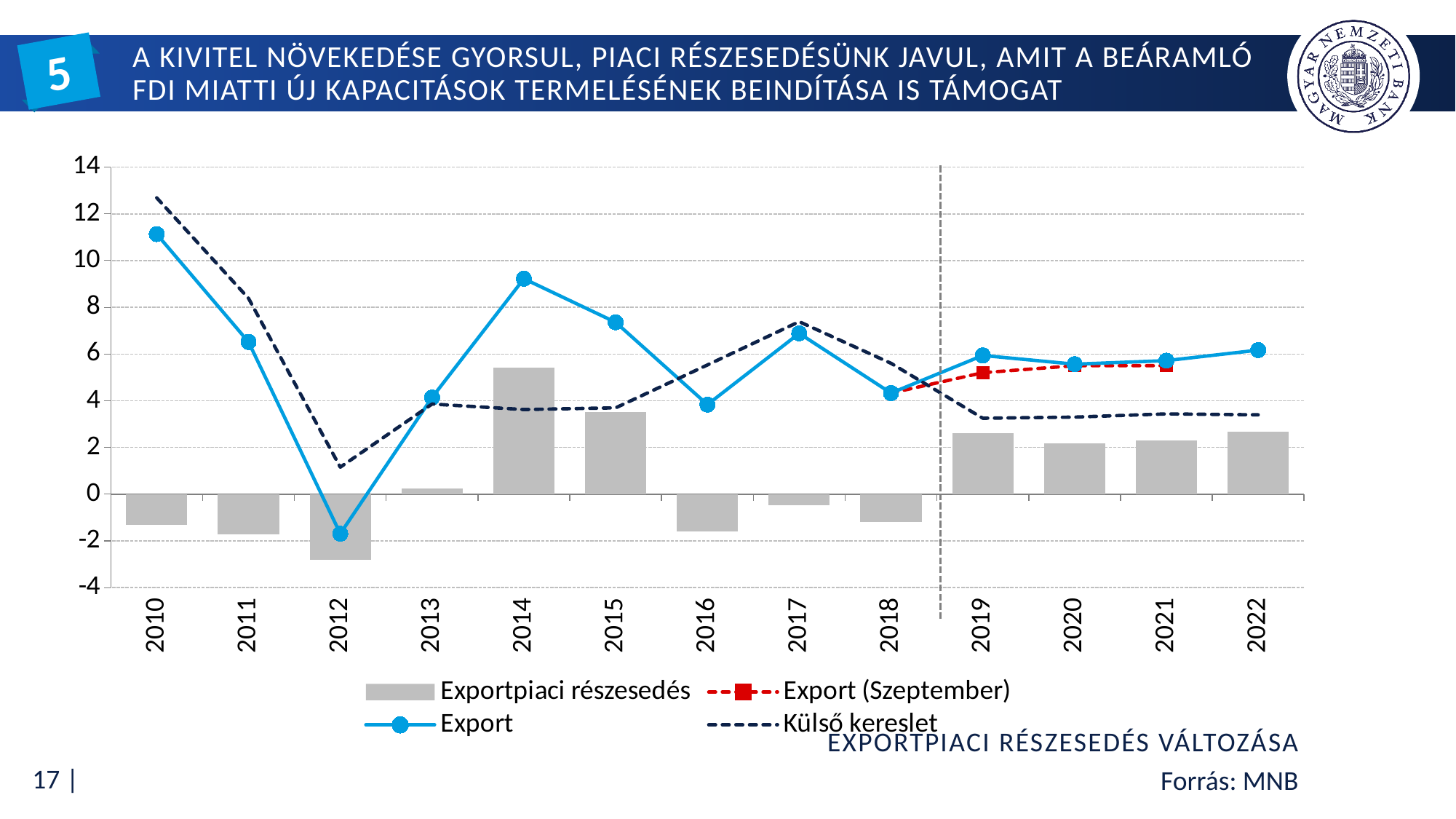
Is the Külső kereslet value for 2010 greater or less than 12? greater How many series does the legend list? 4 Which is larger, the Export value for 2014 or for 2015? 2014 In which year is the Exportpiaci részesedés bar the lowest? 2012 In which year is the Export line at its highest? 2010 Does the Külső kereslet line rise or fall from 2010 to 2012? fall How many years are shown on the x axis? 13 Is the Exportpiaci részesedés value for 2012 greater or less than -2? less Is the Export value for 2010 greater or less than 10? greater What kind of chart is shown on the slide? A combined bar and line chart In which year is the Export line at its lowest? 2012 In which year is the Exportpiaci részesedés bar the tallest? 2014